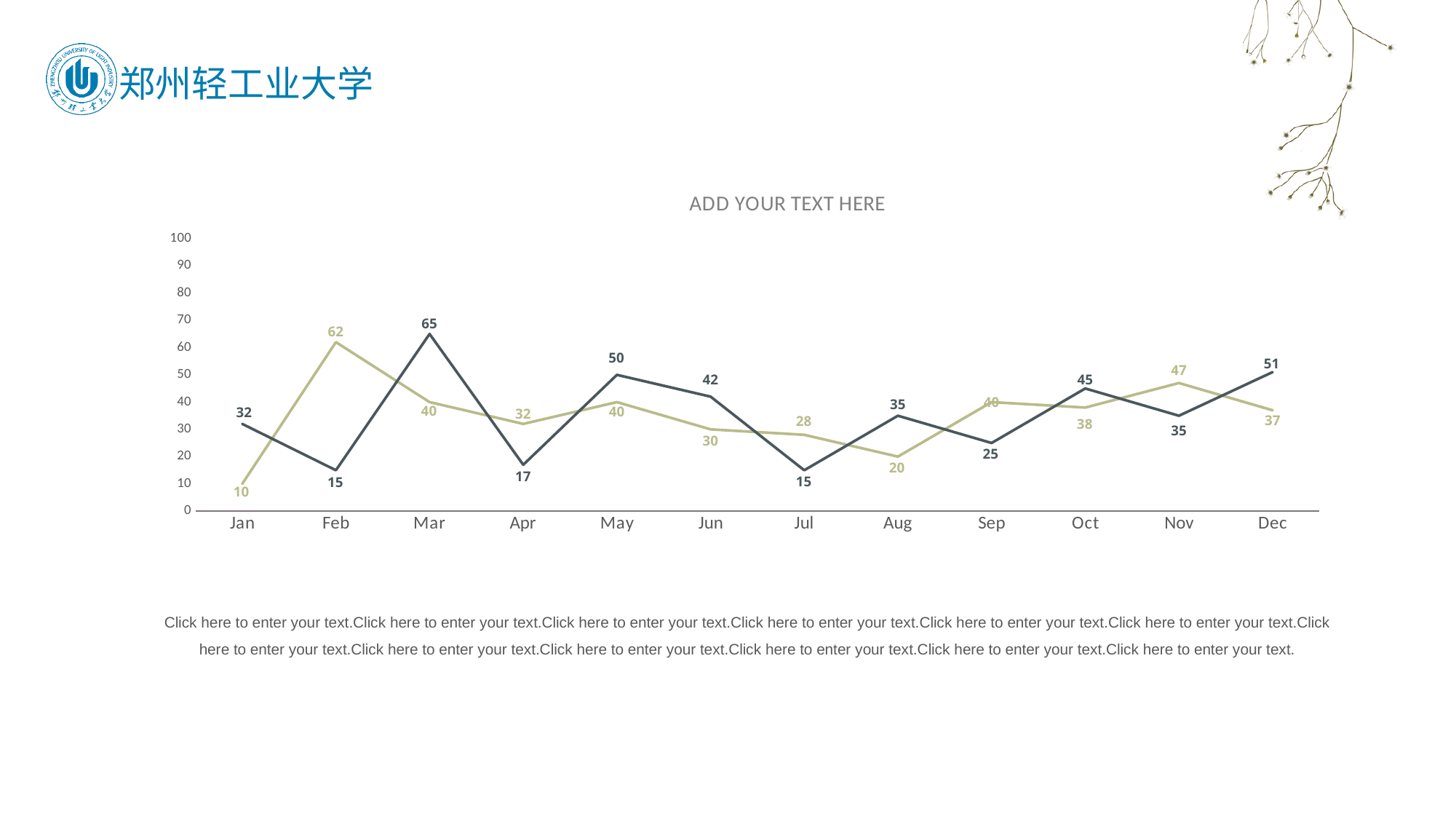
What is the value of the light green line in Feb? 62 How many months are plotted along the x axis? 12 What is the difference between the dark grey line's values in Mar and Apr? 48 In which month does the light green line have its lowest value? Jan What is the value of the dark grey line in Dec? 51 What is the title of the chart? ADD YOUR TEXT HERE What is the difference between the dark grey line and the light green line in Jan? 22 Does the dark grey line rise or fall from Sep to Oct? rise In which month does the dark grey line reach its highest value? Mar What is the value of the dark grey line in Mar? 65 Which line has the higher value in Nov, the dark grey line or the light green line? light green line What type of chart is shown on the slide? line chart